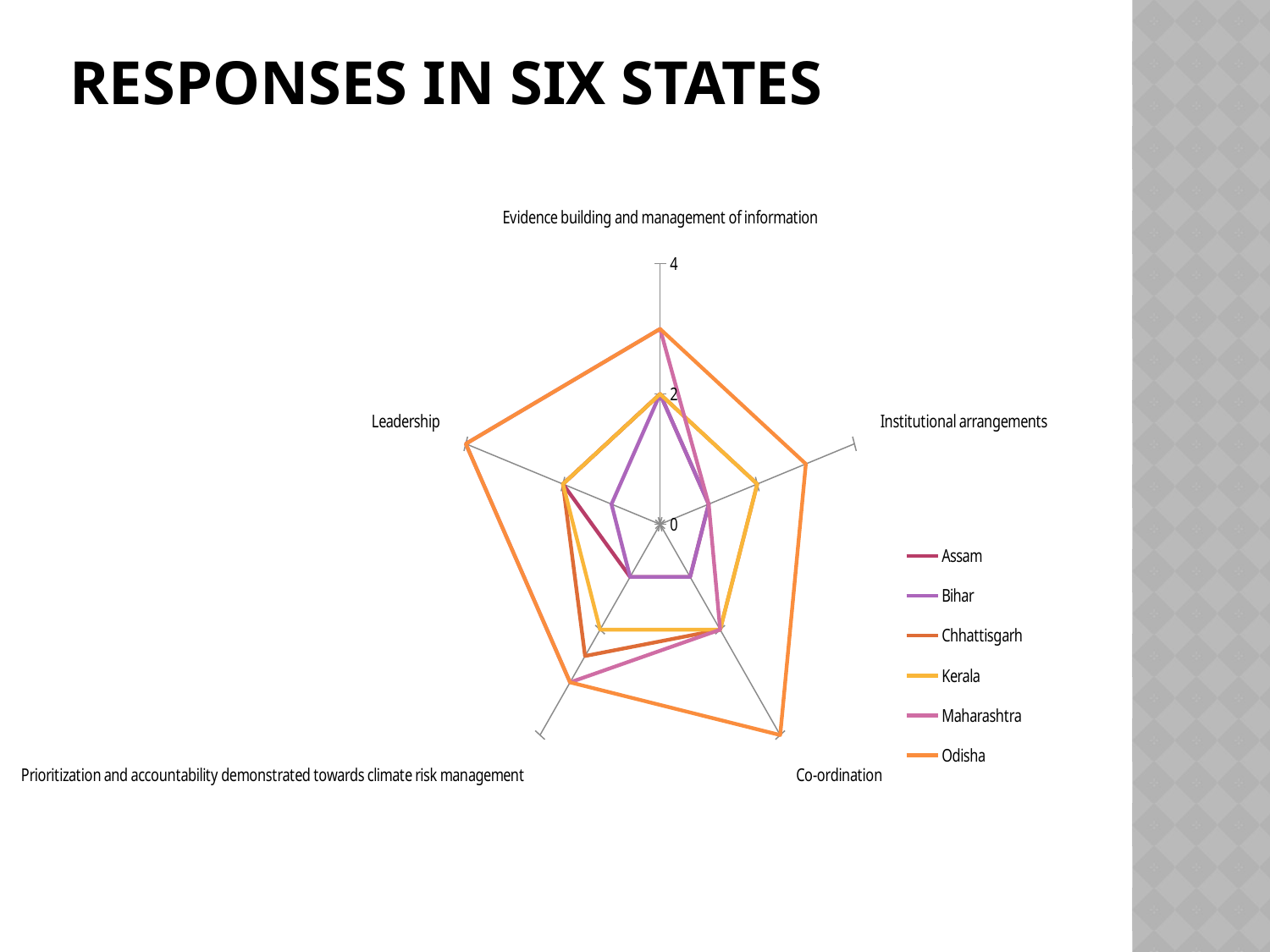
How many axes (categories) does the radar chart have? 5 Which state has the highest value for Co-ordination? Odisha Which is larger on Institutional arrangements, Kerala or Bihar? Kerala Is the value for Bihar on Leadership greater or less than 2? less Is the value for Odisha on Evidence building and management of information greater or less than 2? greater Which is larger on Co-ordination, Odisha or Kerala? Odisha Is the value for Bihar on Institutional arrangements greater or less than 2? less How many series does the legend list? 6 Which state is listed last in the legend? Odisha What kind of chart is shown on the slide? radar chart Which state has the highest value for Institutional arrangements? Odisha